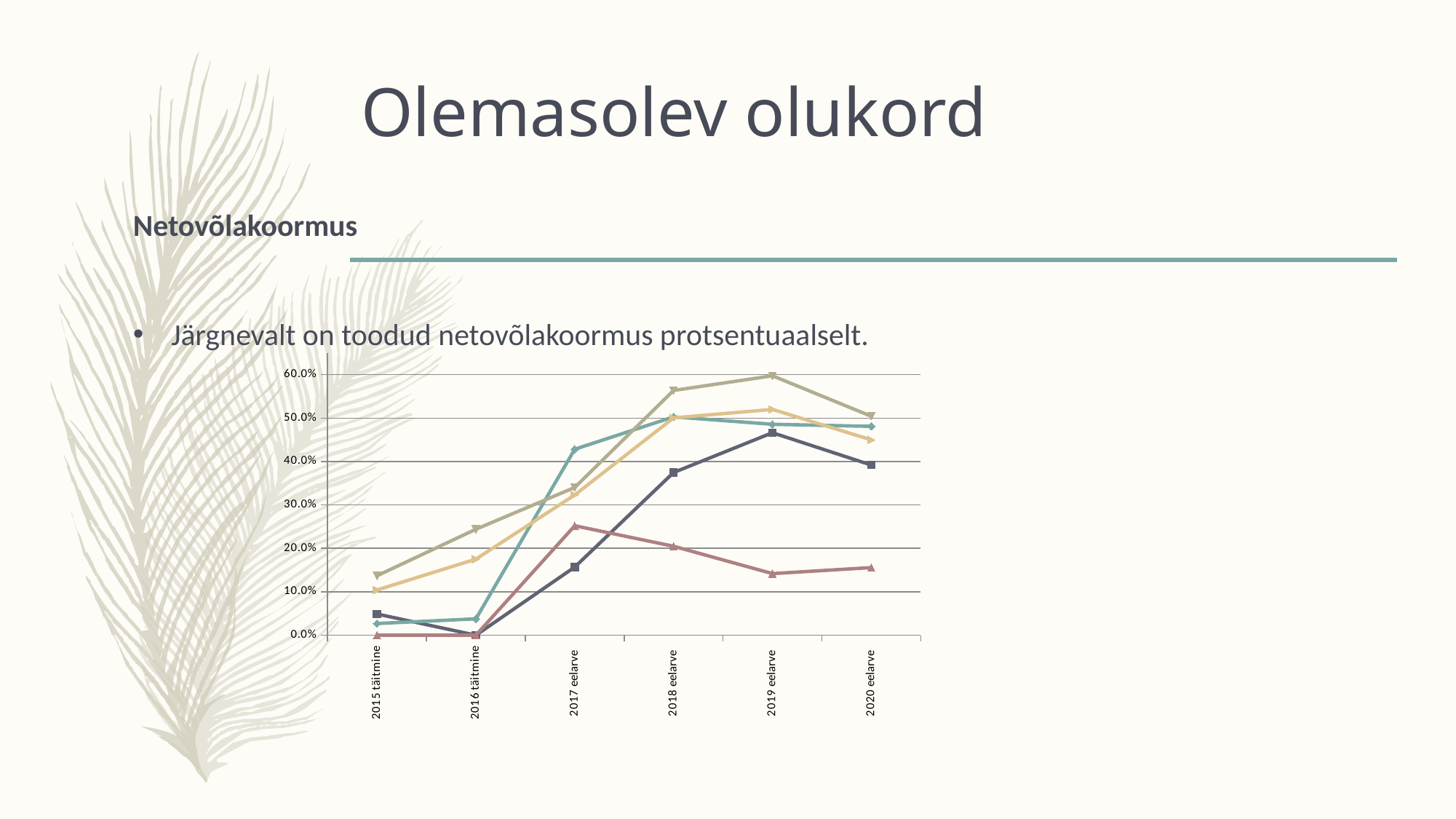
What kind of chart is shown on the slide? line chart Is the value of the dark navy line at 2019 eelarve greater or less than 40.0%? greater Is the value of the dark navy line at 2016 täitmine greater or less than 10.0%? less Which line has the lowest value at 2020 eelarve? the red line How many categories are shown on the x axis of the chart? 6 How many lines are plotted on the chart? 5 Which line has the highest value at 2019 eelarve? the olive line Is the value of the teal line at 2017 eelarve greater or less than 40.0%? greater At which category does the red line reach its highest value? 2017 eelarve What is the last category on the x axis of the chart? 2020 eelarve What is the first category on the x axis of the chart? 2015 täitmine